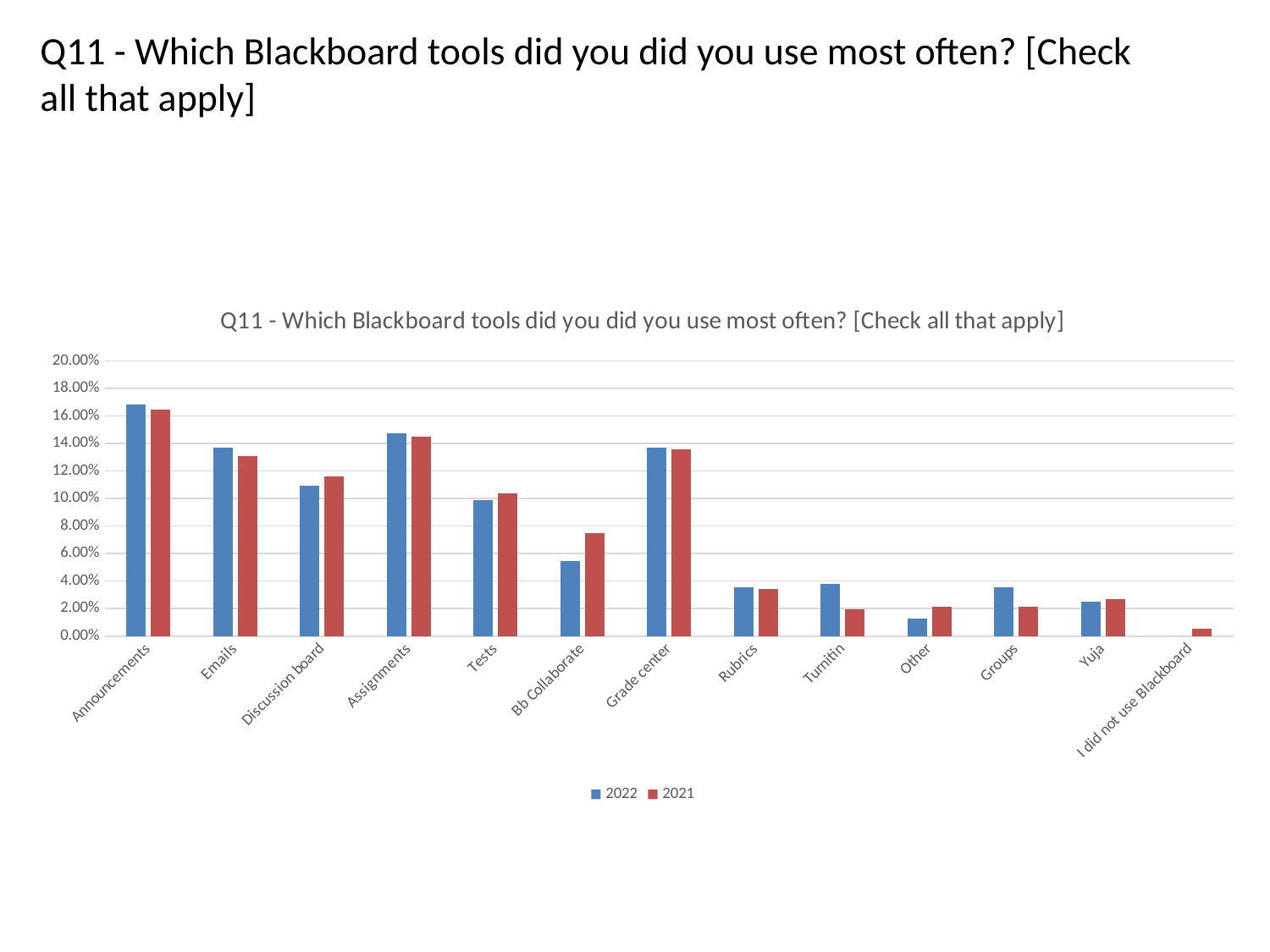
What kind of chart is shown on the slide? bar chart Is the 2021 value for Bb Collaborate greater or less than 6.00%? greater Is the 2022 value for Grade center greater or less than 12.00%? greater Which category has the highest value for 2022? Announcements Is the 2022 value for Announcements greater or less than 16.00%? greater For Turnitin, which year has the larger value, 2022 or 2021? 2022 Which category has the lowest value for 2021? I did not use Blackboard Which colour represents the 2021 series in the chart? red How many series does the legend list? 2 For Bb Collaborate, which year has the larger value, 2022 or 2021? 2021 How many categories are shown on the x axis? 13